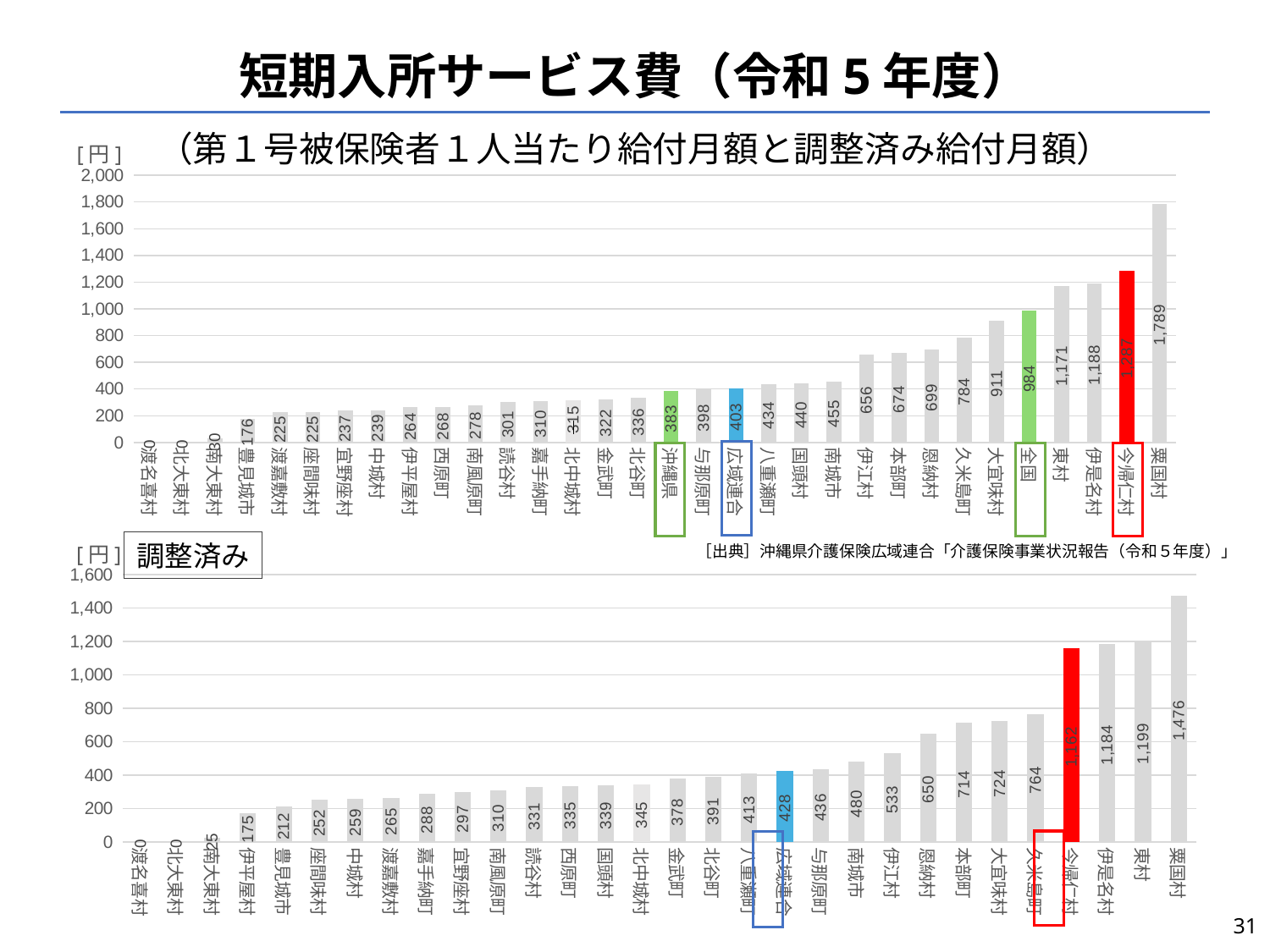
What type of chart is the top chart? bar chart In the bottom chart (調整済み), do the values rise or fall from left to right? rise In the bottom chart (調整済み), which category has the highest value? 粟国村 In the top chart, which category has the highest value? 粟国村 In the top chart, which is larger, 沖縄県 or 広域連合? 広域連合 In the top chart, what is the value for 粟国村? 1,789 In the top chart, what is the value for 全国? 984 In the top chart, what is the value for 広域連合? 403 In the bottom chart (調整済み), what is the difference between 東村 and 伊是名村? 15 In the bottom chart (調整済み), what is the value for 今帰仁村? 1,162 In the bottom chart (調整済み), what is the value for 広域連合? 428 In the top chart, what is the difference between 今帰仁村 and 全国? 303